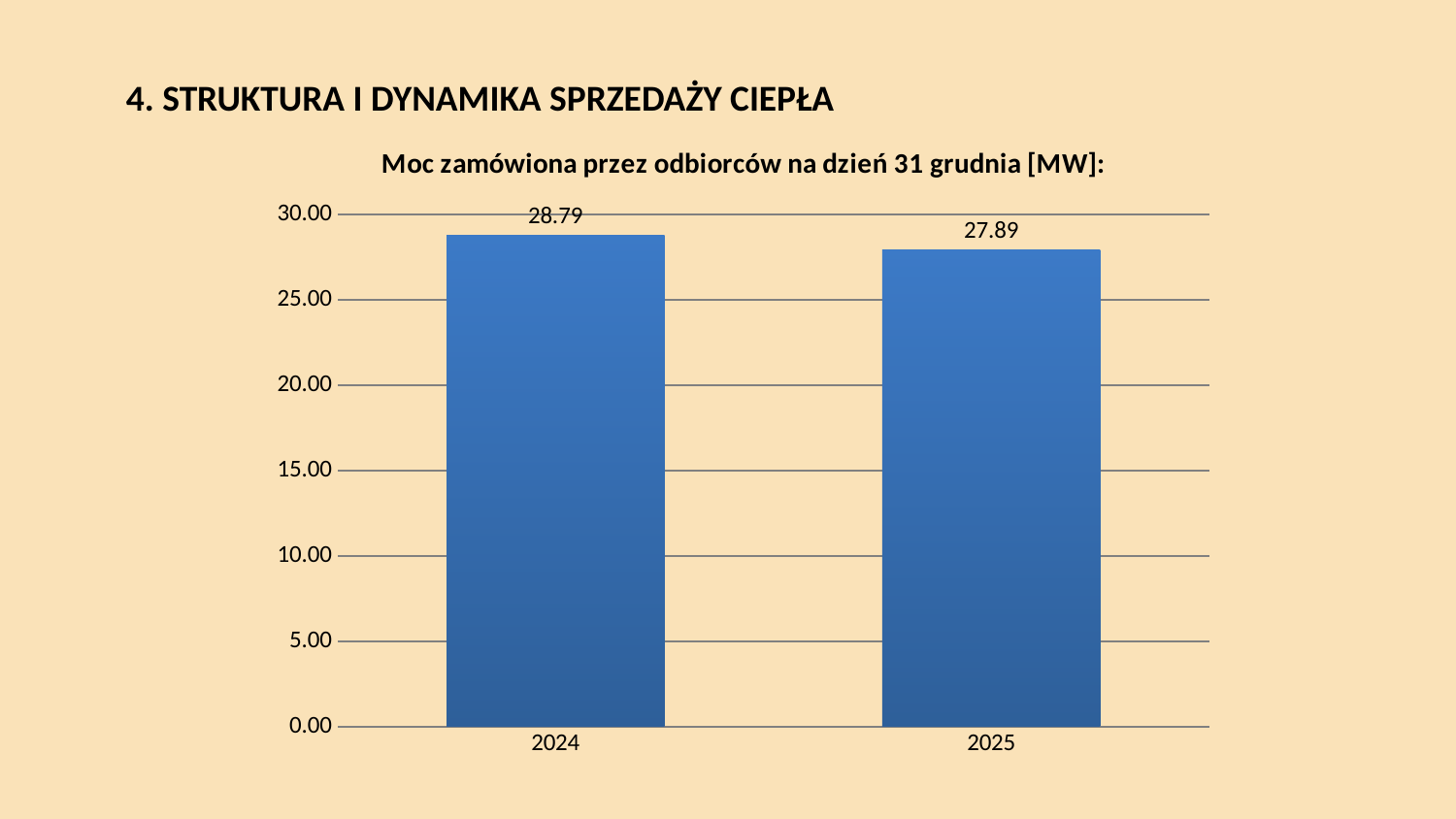
What is the difference between the values for 2024 and 2025? 0.90 How many categories are shown on the x axis? 2 What is the value for 2025? 27.89 What is the value for 2024? 28.79 Is the value for 2025 greater or less than 25.00? greater Which year has the highest value? 2024 Is the value for 2024 greater or less than 30.00? less Do the values rise or fall from 2024 to 2025? fall What is the title of the chart? Moc zamówiona przez odbiorców na dzień 31 grudnia [MW]: What kind of chart is shown on the slide? bar chart Which is larger, the value for 2024 or the value for 2025? 2024 Which year has the lowest value? 2025